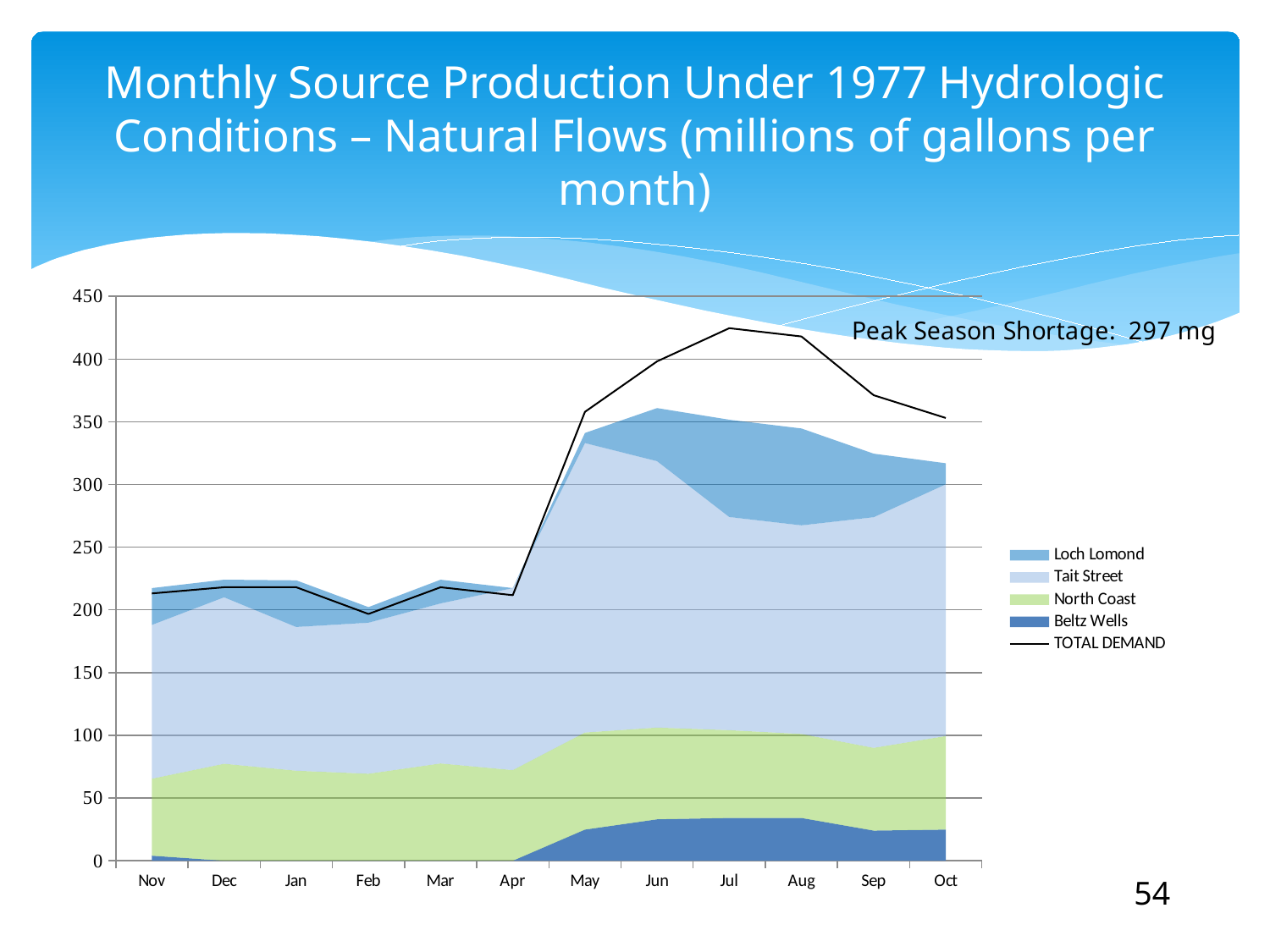
What peak season shortage is stated on the chart? 297 mg Which is larger, TOTAL DEMAND in Jul or TOTAL DEMAND in Nov? Jul Does TOTAL DEMAND rise or fall from Apr to Jul? rise Is the TOTAL DEMAND value for Feb greater or less than 250? less Which series is listed first in the legend? Loch Lomond Is the TOTAL DEMAND value for Jul greater or less than 400? greater How many months are shown along the x axis? 12 Is the total stacked production for Oct greater or less than 250? greater In which month is TOTAL DEMAND highest? Jul In which month is TOTAL DEMAND lowest? Feb How many series does the legend list? 5 What kind of chart is shown on the slide? area chart